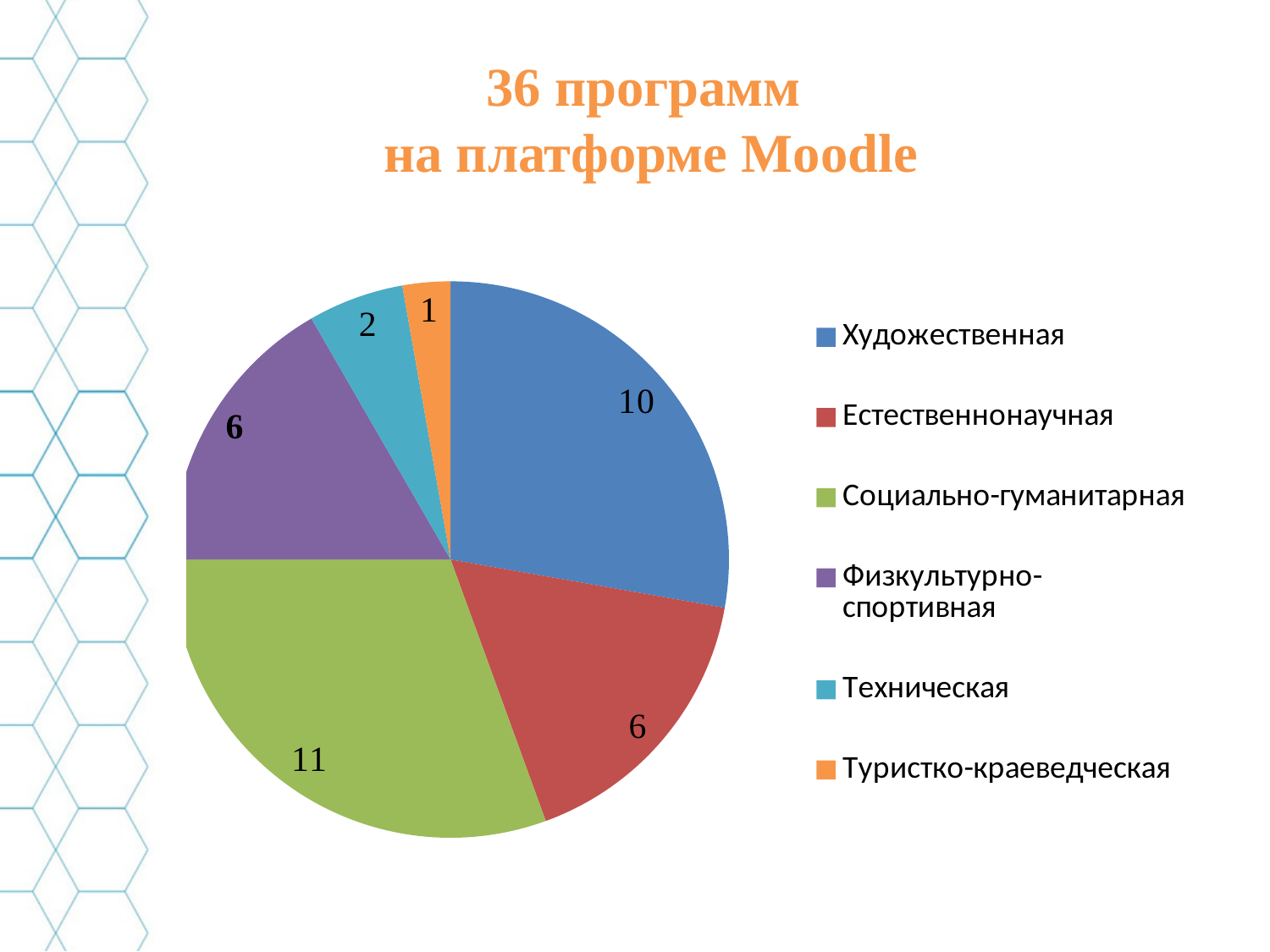
What is the value for Социально-гуманитарная? 11 How many categories does the pie chart have? 6 Which category has the largest slice of the pie? Социально-гуманитарная Which is larger, the value for Естественнонаучная or the value for Техническая? Естественнонаучная What is the value for Художественная? 10 Which category has the smallest slice of the pie? Туристко-краеведческая What is the difference between the values for Социально-гуманитарная and Художественная? 1 What is the total of all slices in the pie chart? 36 What is the title of the slide? 36 программ на платформе Moodle What is the value for Техническая? 2 What is the value for Туристко-краеведческая? 1 What type of chart is shown on the slide? pie chart